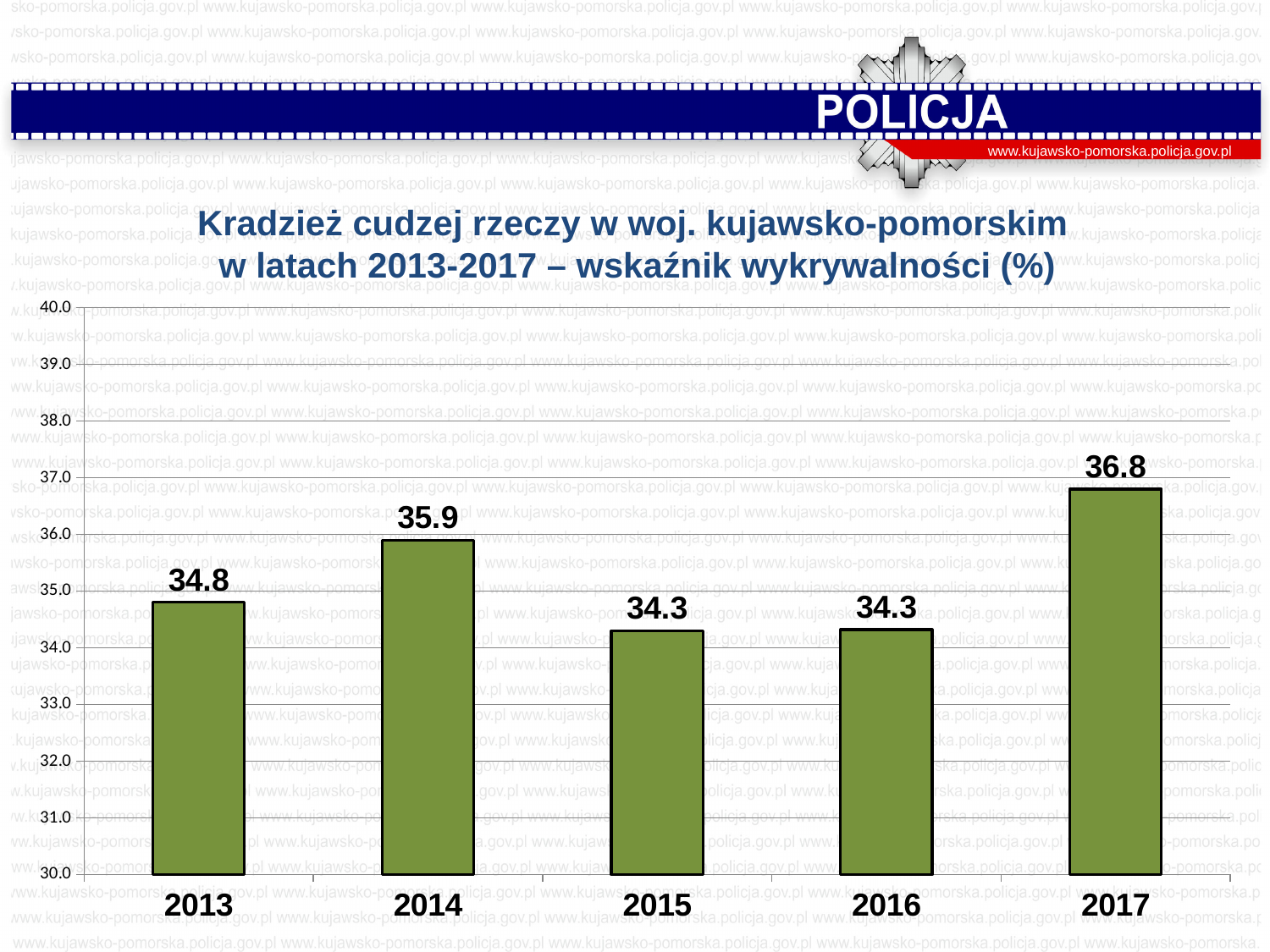
Which is larger, the value for 2014 or the value for 2016? 2014 What is the difference between the values for 2017 and 2014? 0.9 Is the value for 2017 greater or less than 36.0? greater How many years are shown on the x axis? 5 Is the value for 2015 greater or less than 35.0? less What is the title of the chart? Kradzież cudzej rzeczy w woj. kujawsko-pomorskim w latach 2013-2017 – wskaźnik wykrywalności (%) What is the detection rate for 2013? 34.8 What is the detection rate for 2017? 36.8 What is the value shown for 2015? 34.3 What kind of chart is shown on the slide? bar chart Which year has the highest detection rate? 2017 What is the difference between the values for 2014 and 2013? 1.1